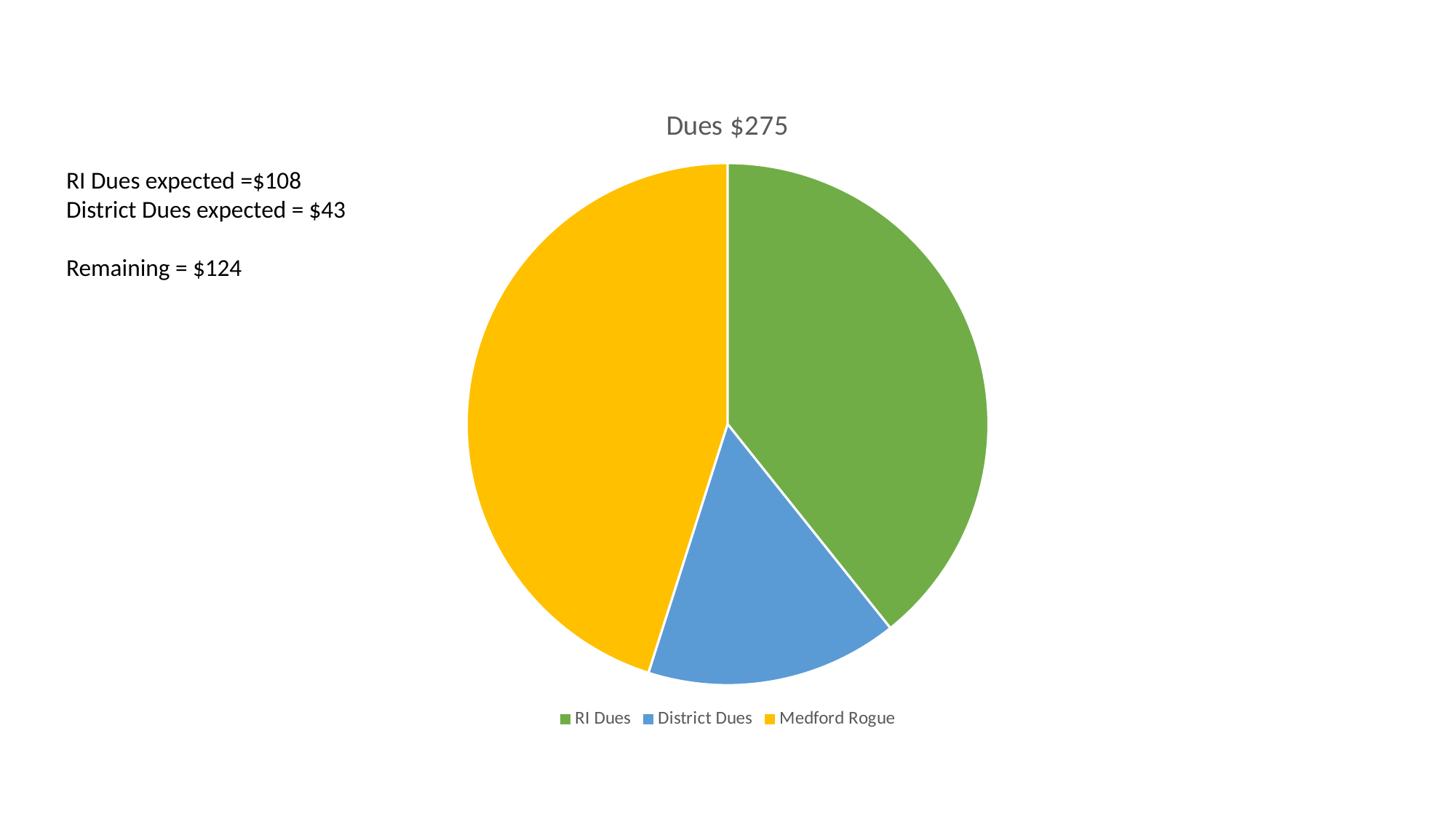
Which slice is larger in the pie chart, RI Dues or District Dues? RI Dues How many entries does the legend of the pie chart list? 3 What kind of chart is shown on the slide? pie chart How many slices does the pie chart have? 3 What is the title of the pie chart? Dues $275 What colour is the Medford Rogue slice in the pie chart? yellow Which slice is larger in the pie chart, Medford Rogue or District Dues? Medford Rogue Which slice of the pie chart is the smallest? District Dues Which slice of the pie chart is the largest? Medford Rogue